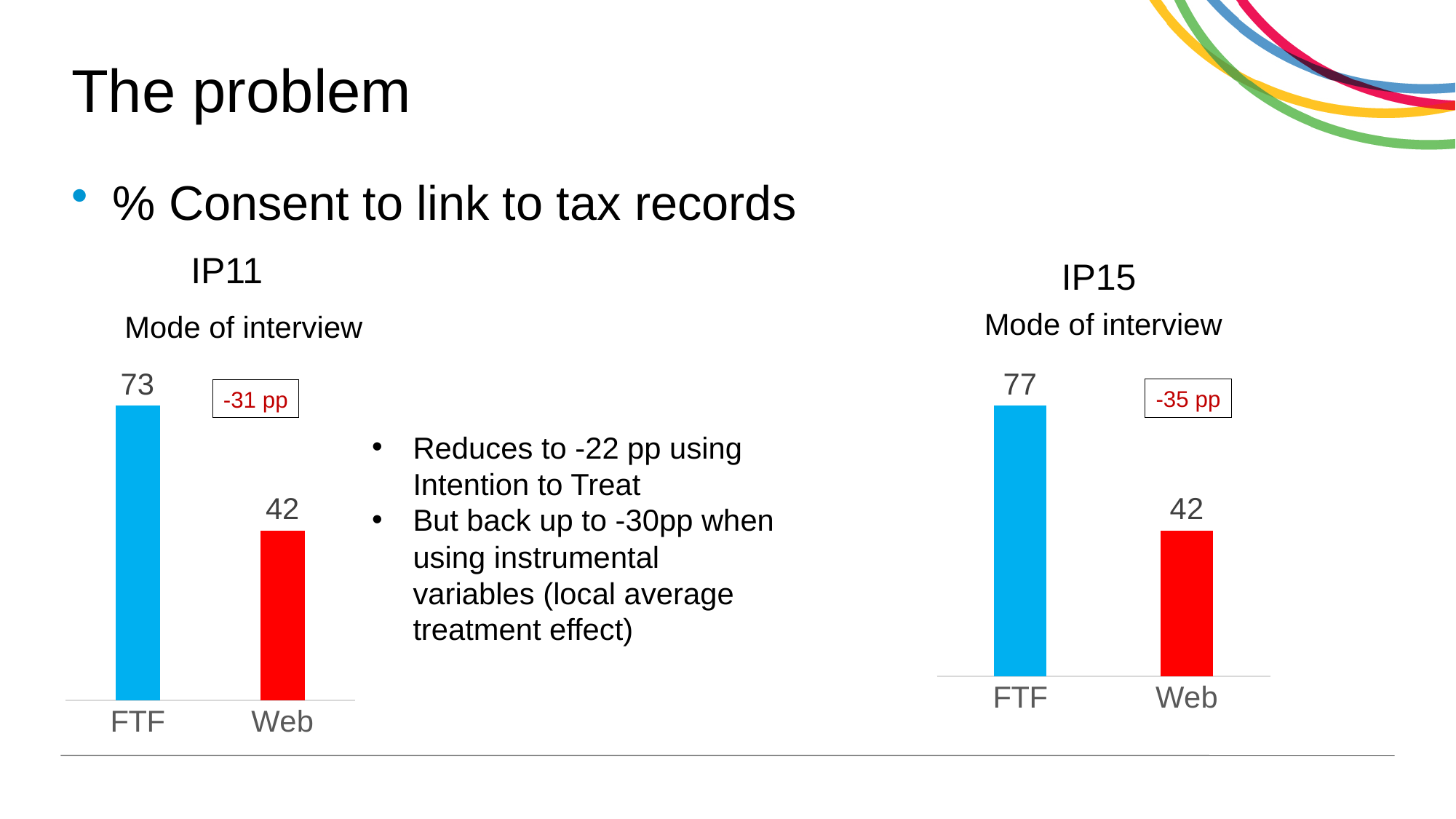
In the IP11 chart, what colour is the Web bar? Red In the IP11 chart, what is the value for Web? 42 In the IP15 chart, which is larger, FTF or Web? FTF How many categories are shown in the IP11 chart? 2 In the IP15 chart, what is the value for FTF? 77 In the IP15 chart, which mode of interview has the lowest value? Web What kind of chart is the IP15 chart? Bar chart In the IP15 chart, what is the difference between the FTF and Web values? 35 In the IP15 chart, what is the value for Web? 42 In the IP11 chart, what is the value for FTF? 73 In the IP11 chart, what is the difference between the FTF and Web values? 31 In the IP11 chart, which mode of interview has the highest value? FTF